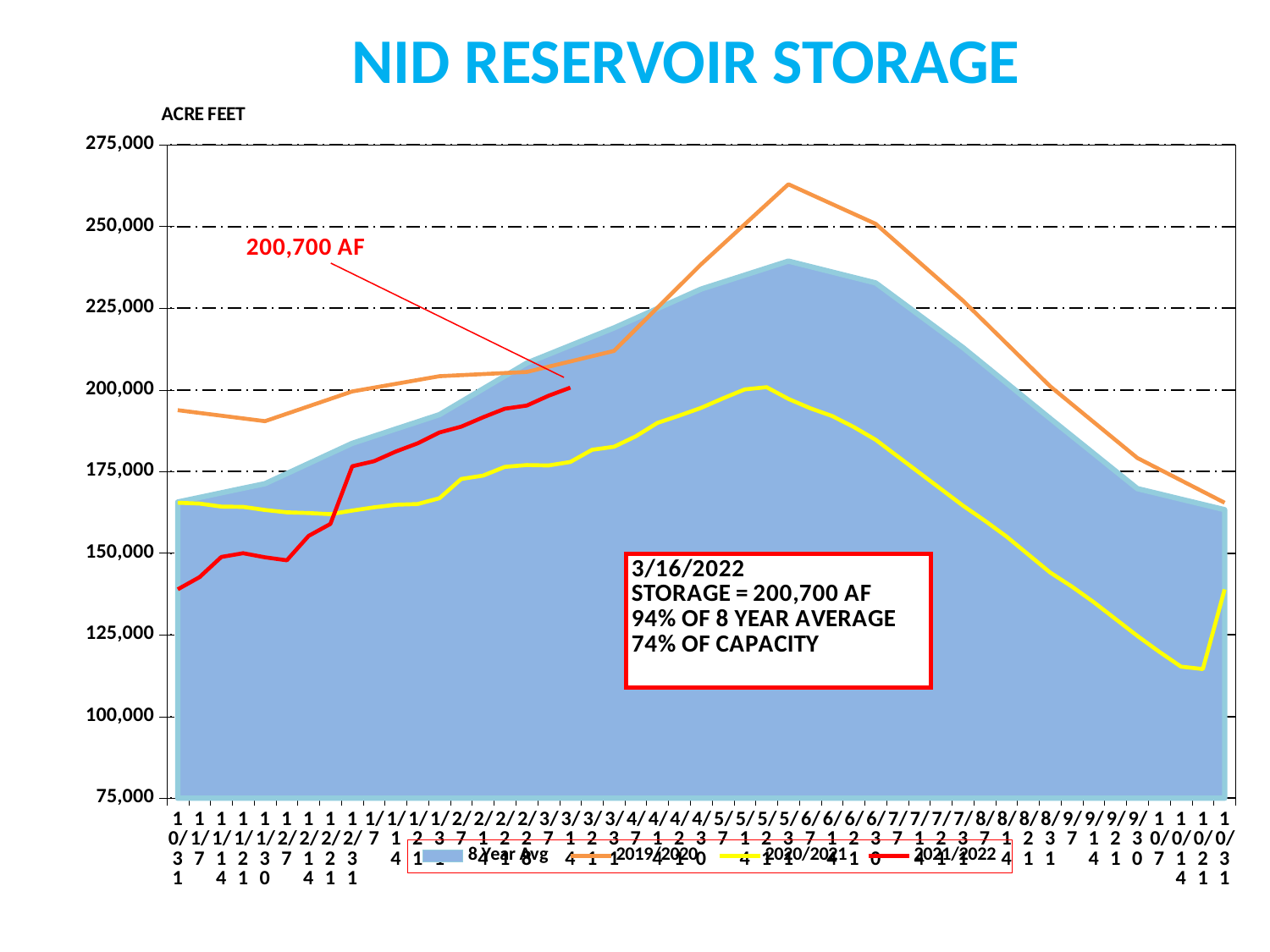
How many series does the legend list? 4 According to the text box, what percent of capacity is the storage on 3/16/2022? 74% What unit label is shown above the y axis? ACRE FEET Which series drops to the lowest value on the chart? 2020/2021 Is the peak value of the 2019/2020 series greater or less than 250,000? greater What kind of chart is used to plot the 2021/2022 series? line chart What is the title of the chart? NID RESERVOIR STORAGE Is the peak value of the 2020/2021 series greater or less than 225,000? less At the last plotted point of the 2021/2022 line, which is higher: the 2021/2022 series or the 2019/2020 series? 2019/2020 According to the text box, what percent of the 8 year average is the storage on 3/16/2022? 94% Which series reaches the highest peak on the chart? 2019/2020 What storage value is labelled at the end of the 2021/2022 line? 200,700 AF